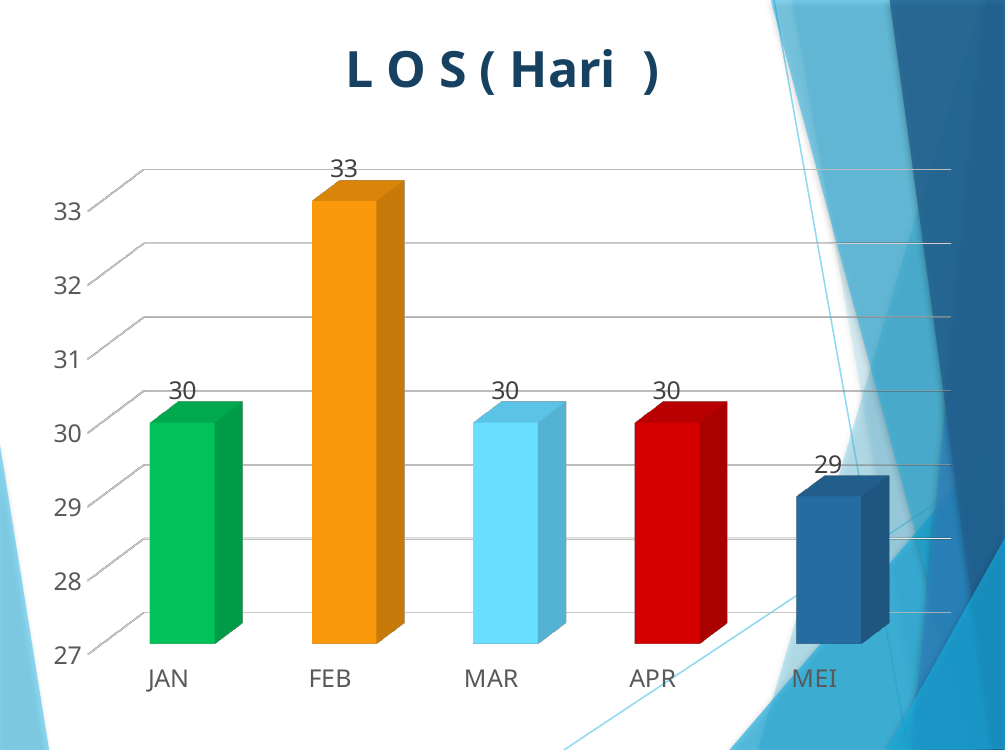
Which is larger, the value for FEB or the value for MAR? FEB Which month has the highest value? FEB How many months are shown on the x axis? 5 What is the value for MEI? 29 Which month has the lowest value? MEI What is the difference between the values for FEB and MEI? 4 What is the value for FEB? 33 Is the value for FEB greater or less than 32? greater What is the title of the chart? L O S ( Hari ) What is the value for JAN? 30 What is the difference between the values for FEB and APR? 3 What kind of chart is shown on the slide? bar chart